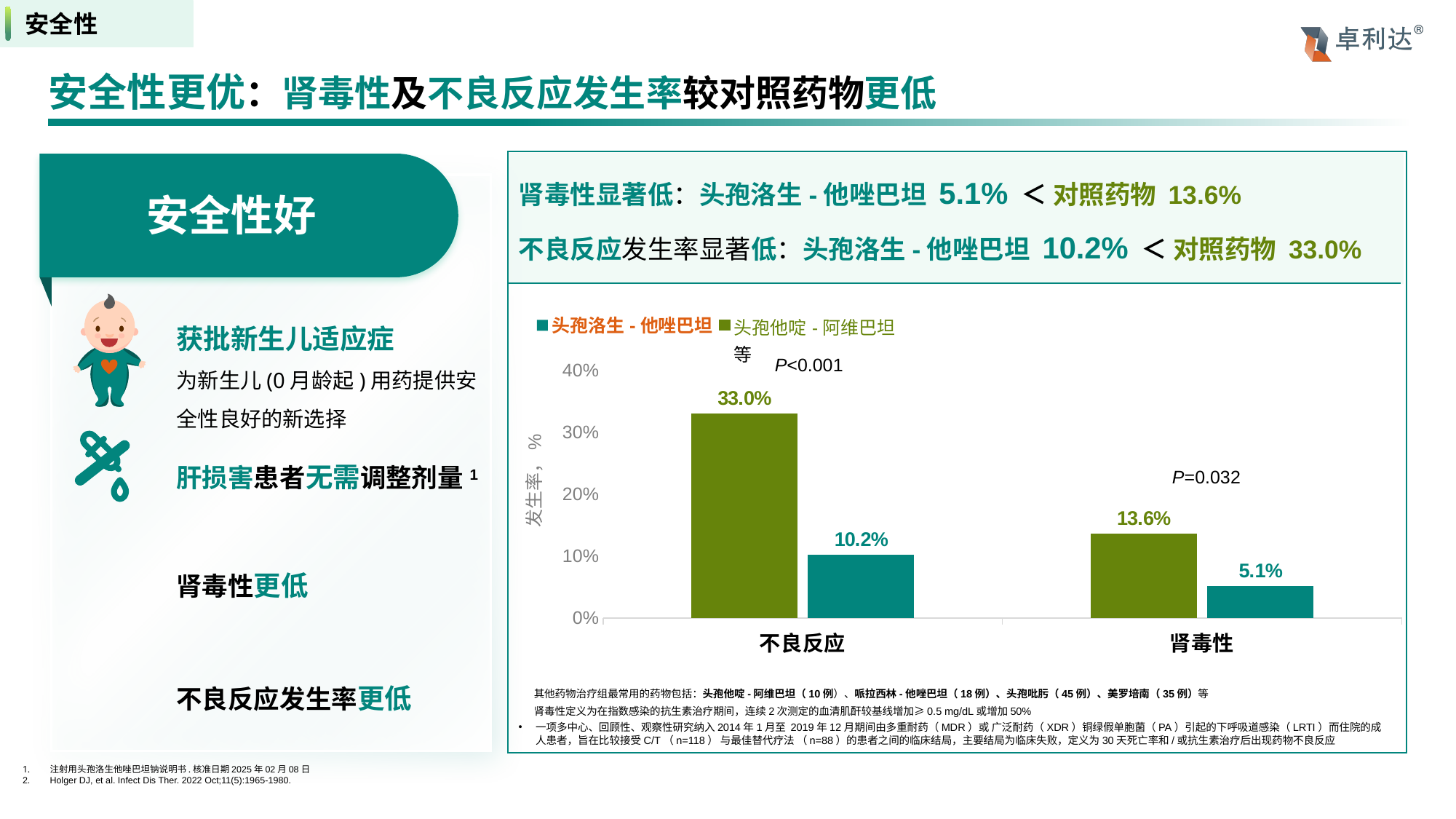
不良反应发生率中，对照组与头孢洛生-他唑巴坦组相差多少个百分点？ 22.8个百分点 图中四个柱子里数值最高的是哪一个？ 头孢他啶-阿维巴坦等组的不良反应（33.0%） 图例中列出了几个系列？ 2 图中头孢洛生-他唑巴坦组的肾毒性发生率是多少？ 5.1% 图中横轴共有几个类别？ 2 图中四个柱子里数值最低的是哪一个？ 头孢洛生-他唑巴坦组的肾毒性（5.1%） 图中头孢洛生-他唑巴坦组的不良反应发生率是多少？ 10.2% 肾毒性发生率中，对照组与头孢洛生-他唑巴坦组相差多少个百分点？ 8.5个百分点 图中头孢他啶-阿维巴坦等对照组的不良反应发生率是多少？ 33.0% 在肾毒性这一类别中，哪个组的发生率更高？ 头孢他啶-阿维巴坦等 图中头孢他啶-阿维巴坦等对照组的肾毒性发生率是多少？ 13.6% 这是什么类型的图表？ 柱状图（条形图）